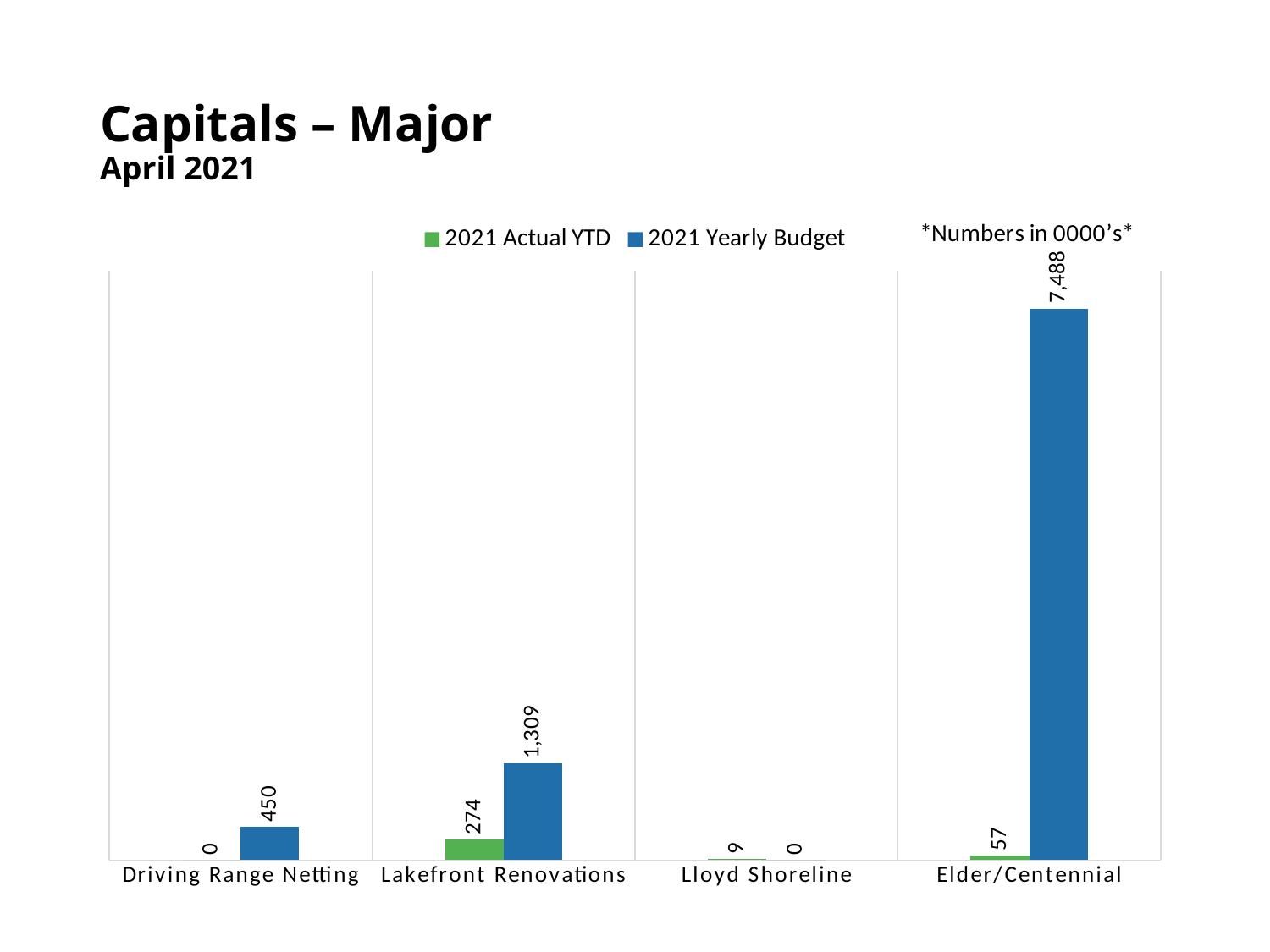
What is the 2021 Actual YTD value for Lakefront Renovations? 274 What kind of chart is shown on the slide? Bar chart What is the 2021 Yearly Budget value for Elder/Centennial? 7,488 Which category has the highest 2021 Yearly Budget? Elder/Centennial Which is larger for Elder/Centennial: the 2021 Actual YTD or the 2021 Yearly Budget? 2021 Yearly Budget What is the 2021 Yearly Budget value for Driving Range Netting? 450 What is the difference between the 2021 Yearly Budget and the 2021 Actual YTD for Lakefront Renovations? 1,035 Which category has the lowest 2021 Yearly Budget? Lloyd Shoreline How many series does the legend list? 2 What note about the units appears above the chart? *Numbers in 0000's* What is the 2021 Actual YTD value for Lloyd Shoreline? 9 How many categories are shown on the x axis? 4